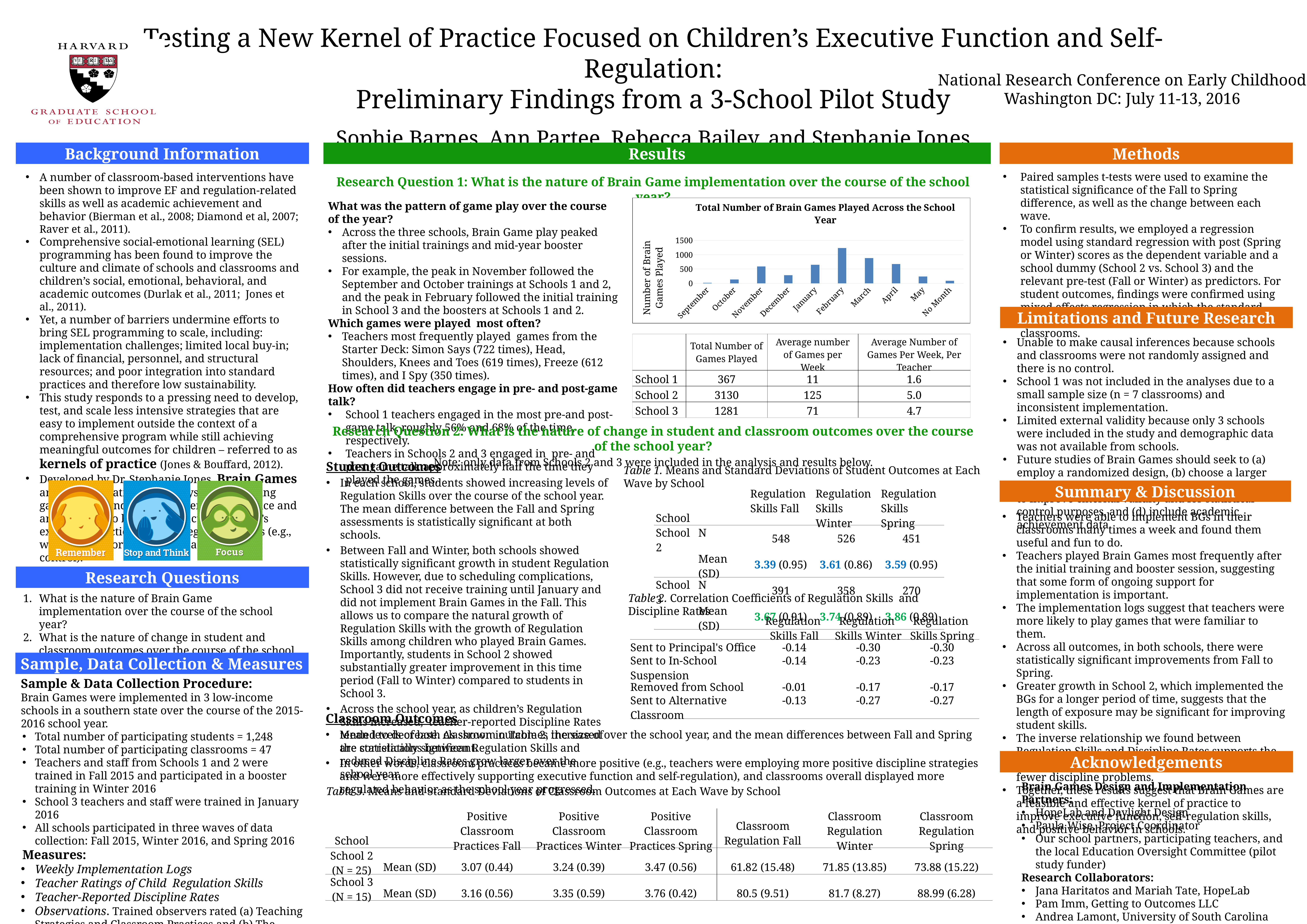
In the Total Number of Brain Games Played chart, is the value for February greater or less than 1000? greater In the Total Number of Brain Games Played chart, which category has the lowest number of games played? September In the Total Number of Brain Games Played chart, which has more games played, November or December? November In the Total Number of Brain Games Played chart, is the value for March greater or less than 1000? less How many categories are shown on the x axis of the Total Number of Brain Games Played chart? 10 In the Total Number of Brain Games Played chart, do the values rise or fall from February to May? fall In the Total Number of Brain Games Played chart, which has more games played, February or March? February What kind of chart is used to show the Total Number of Brain Games Played Across the School Year? bar chart In the Total Number of Brain Games Played chart, is the value for November greater or less than 500? greater In the Total Number of Brain Games Played chart, which month has the highest number of games played? February What is the label on the vertical axis of the Total Number of Brain Games Played chart? Number of Brain Games Played